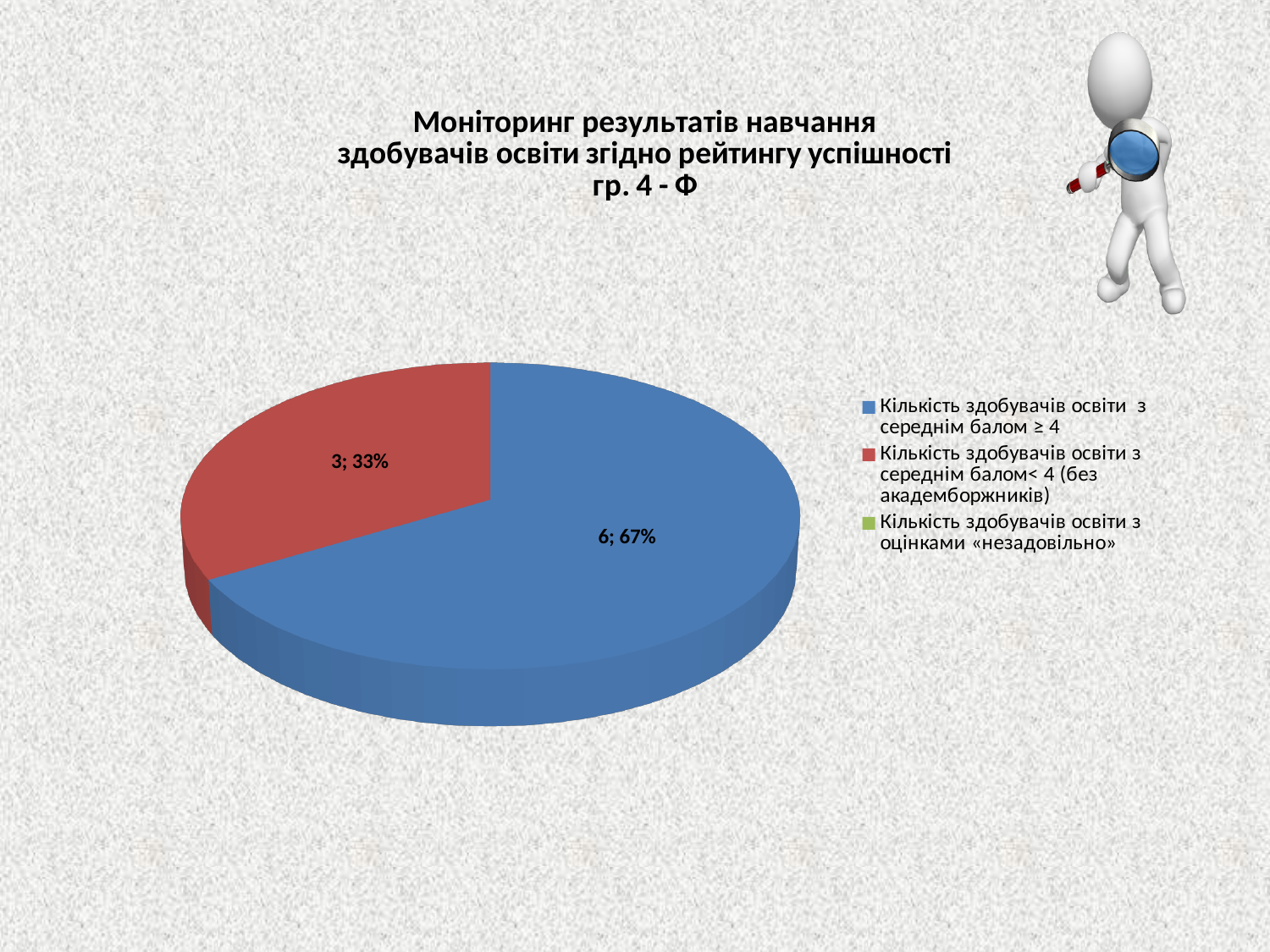
What share of the pie does 'Кількість здобувачів освіти з середнім балом ≥ 4' take? 67% Which category has the largest slice? Кількість здобувачів освіти з середнім балом ≥ 4 Which of the two visible slices is smaller? Кількість здобувачів освіти з середнім балом< 4 (без академборжників) What is the value for 'Кількість здобувачів освіти з середнім балом ≥ 4'? 6 What colour is the slice for 'Кількість здобувачів освіти з середнім балом ≥ 4'? blue Which is larger: the value for students with average score ≥ 4 or the value for students with average score < 4? students with average score ≥ 4 What is the difference between the value for students with average score ≥ 4 and the value for students with average score < 4? 3 What kind of chart is shown on the slide? pie chart How many slices are visible in the pie chart? 2 What is the value for 'Кількість здобувачів освіти з середнім балом< 4 (без академборжників)'? 3 What share of the pie does 'Кількість здобувачів освіти з середнім балом< 4 (без академборжників)' take? 33% How many entries does the legend list? 3